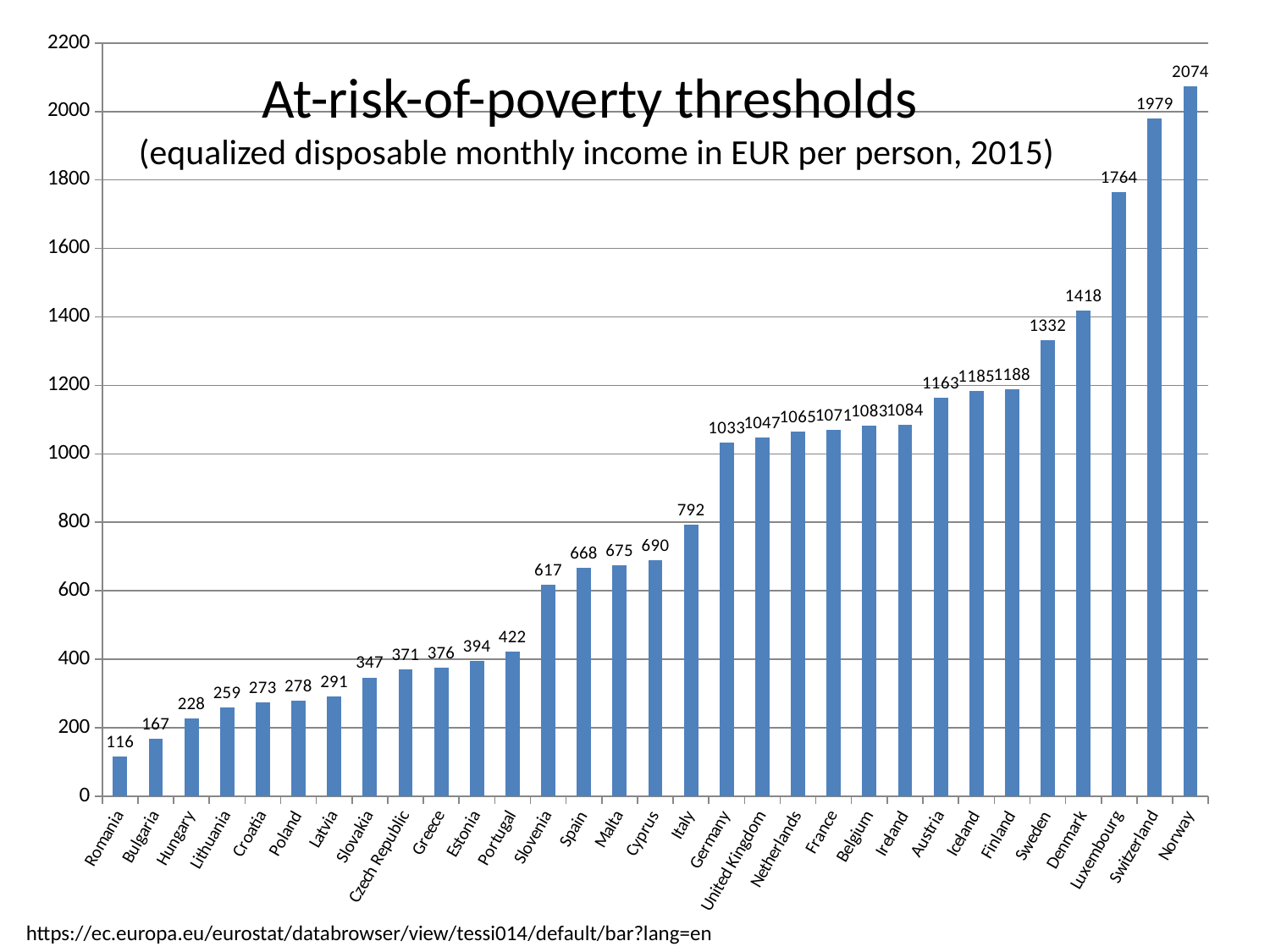
How many countries are shown in the chart? 31 What is the difference between the values for Norway and Switzerland? 95 What is the difference between the values for Italy and Cyprus? 102 What is the at-risk-of-poverty threshold for Germany? 1033 What type of chart is shown on the slide? Bar chart What is the value shown for Luxembourg? 1764 Which country has the highest at-risk-of-poverty threshold? Norway Which country has the lowest at-risk-of-poverty threshold? Romania What is the value shown for Slovenia? 617 Which has a higher value, Sweden or Denmark? Denmark Is the value for Portugal greater or less than 400? greater Do the values rise or fall from left to right along the x axis? Rise